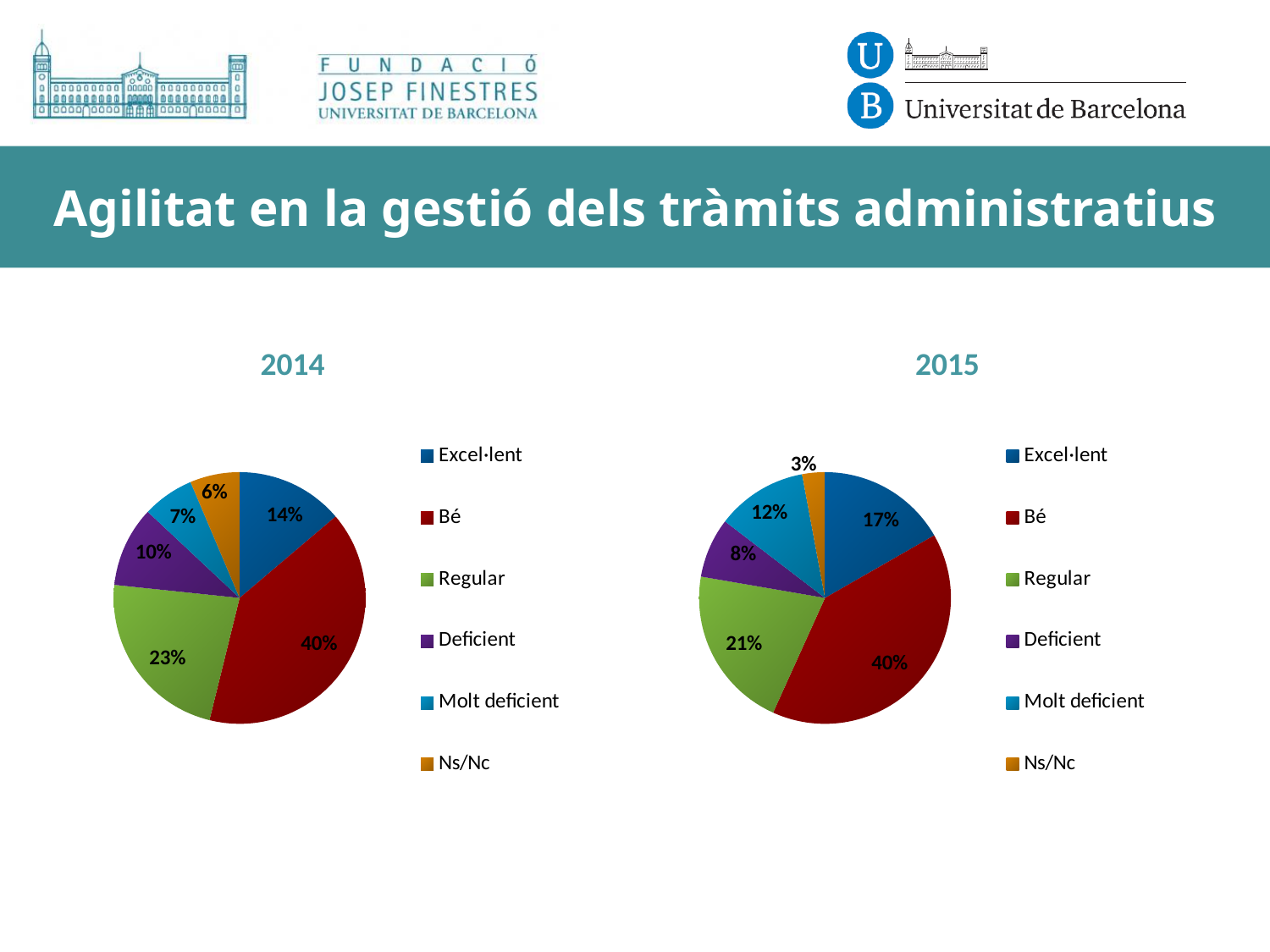
In the 2014 pie chart, which category has the smallest share? Ns/Nc In the 2015 pie chart, what share does Ns/Nc have? 3% Which is larger: the Molt deficient share in 2014 or in 2015? 2015 In the 2015 pie chart, what share does Excel·lent have? 17% In the 2015 pie chart, what colour represents Deficient? Purple How many categories does the 2015 pie chart show? 6 In the 2014 pie chart, what share does Bé have? 40% In the 2014 pie chart, what share does Molt deficient have? 7% What is the difference between the Regular share in 2014 and the Regular share in 2015? 2% In the 2015 pie chart, which category has the smallest share? Ns/Nc In the 2014 pie chart, which category has the largest share? Bé What type of chart is used for the 2014 data? Pie chart